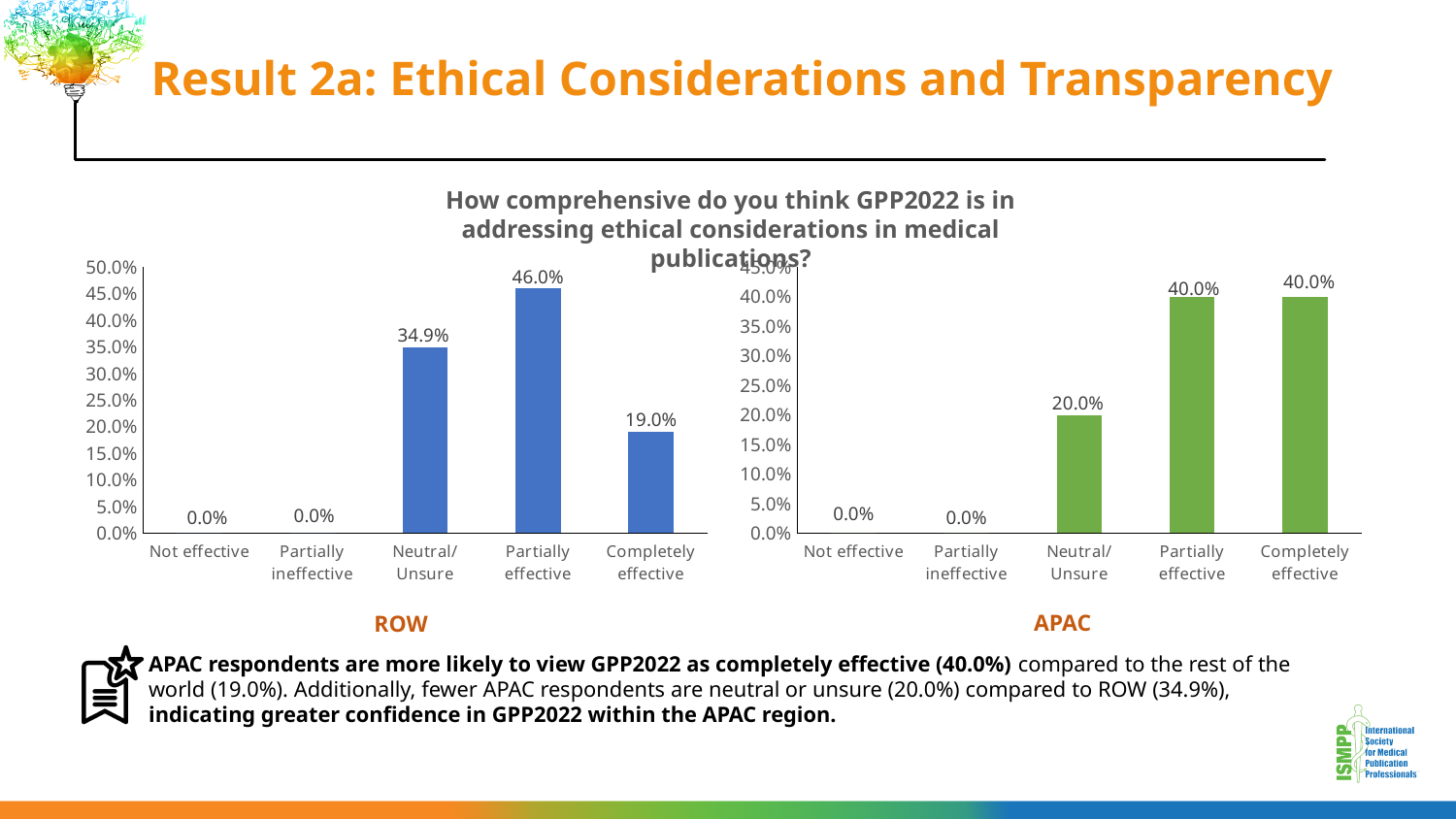
In the ROW chart, which category has the highest value? Partially effective In the ROW chart, what is the difference between Partially effective and Completely effective? 27.0% In the APAC chart, what is the difference between Partially effective and Neutral/Unsure? 20.0% How many categories are shown on the x axis of the APAC chart? 5 In the APAC chart, what is the value for Completely effective? 40.0% In the ROW chart, what is the value for Completely effective? 19.0% In the ROW chart, is the value for Partially effective greater or less than 40.0%? greater What type of chart is the ROW chart? Bar chart In the ROW chart, what is the value for Neutral/Unsure? 34.9% Which is larger: the Completely effective value in the APAC chart or in the ROW chart? APAC What colour are the bars in the APAC chart? Green In the APAC chart, what is the value for Neutral/Unsure? 20.0%